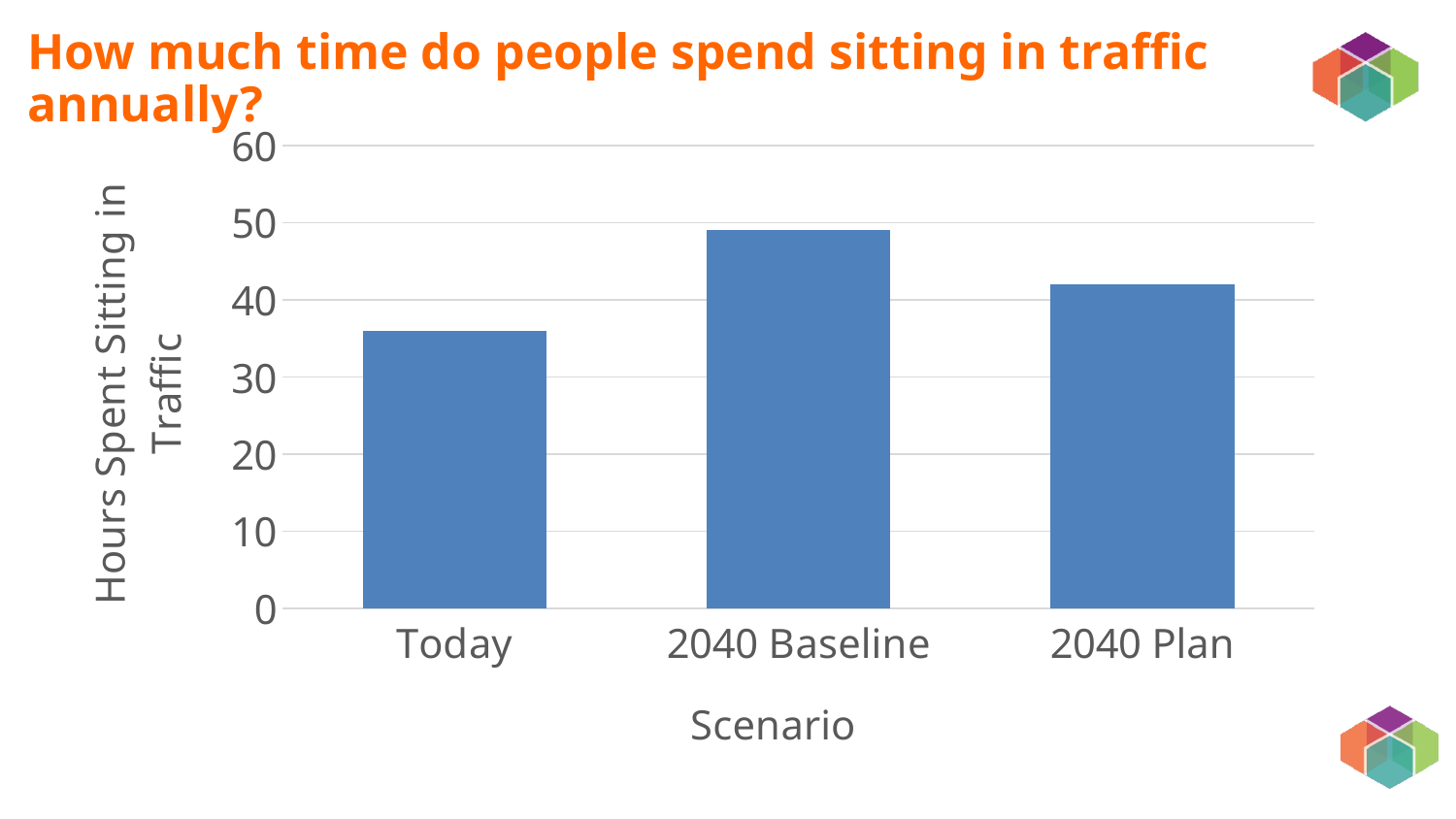
What is the label of the x axis? Scenario Is the value for 2040 Plan greater or less than 50? less Which scenario has the highest hours spent sitting in traffic? 2040 Baseline Which is larger, the value for 2040 Baseline or the value for 2040 Plan? 2040 Baseline What is the label of the y axis? Hours Spent Sitting in Traffic How many scenarios are plotted on the x axis? 3 Which scenario has the lowest hours spent sitting in traffic? Today Which is larger, the value for Today or the value for 2040 Plan? 2040 Plan Is the value for Today greater or less than 30? greater Is the value for Today greater or less than 40? less What type of chart is shown on the slide? bar chart